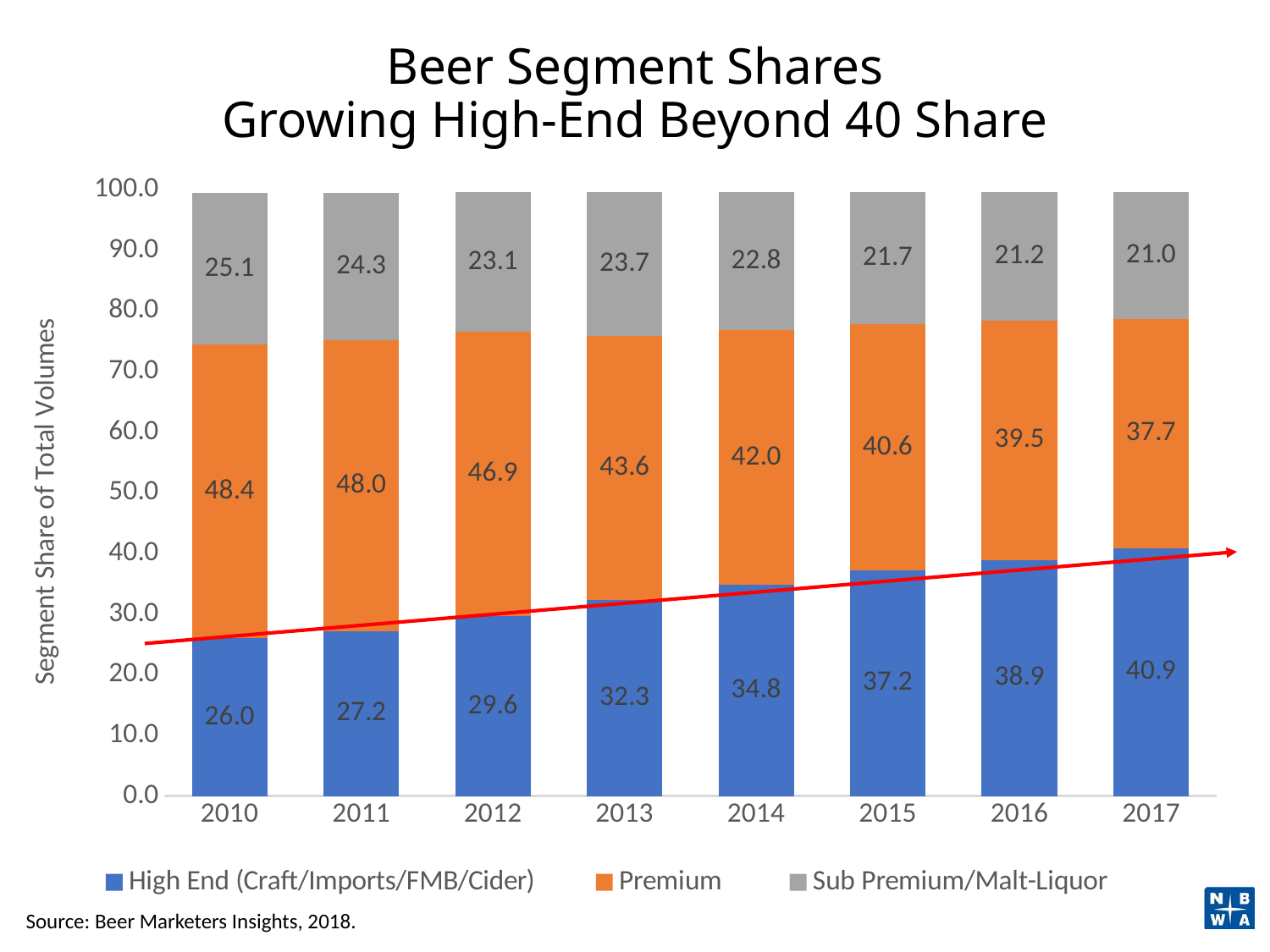
By how much did the High End (Craft/Imports/FMB/Cider) share increase from 2010 to 2017? 14.9 What kind of chart is shown on the slide? Stacked bar chart What is the label on the vertical axis? Segment Share of Total Volumes In which year is the Sub Premium/Malt-Liquor share lowest? 2017 What is the High End (Craft/Imports/FMB/Cider) share in 2017? 40.9 What is the Premium share in 2012? 46.9 How many years are shown on the x axis? 8 Does the Premium share rise or fall from 2010 to 2017? Fall In which year is the High End (Craft/Imports/FMB/Cider) share highest? 2017 In 2015, which segment has the larger share: High End (Craft/Imports/FMB/Cider) or Premium? Premium How many series does the legend list? 3 What is the Sub Premium/Malt-Liquor share in 2014? 22.8